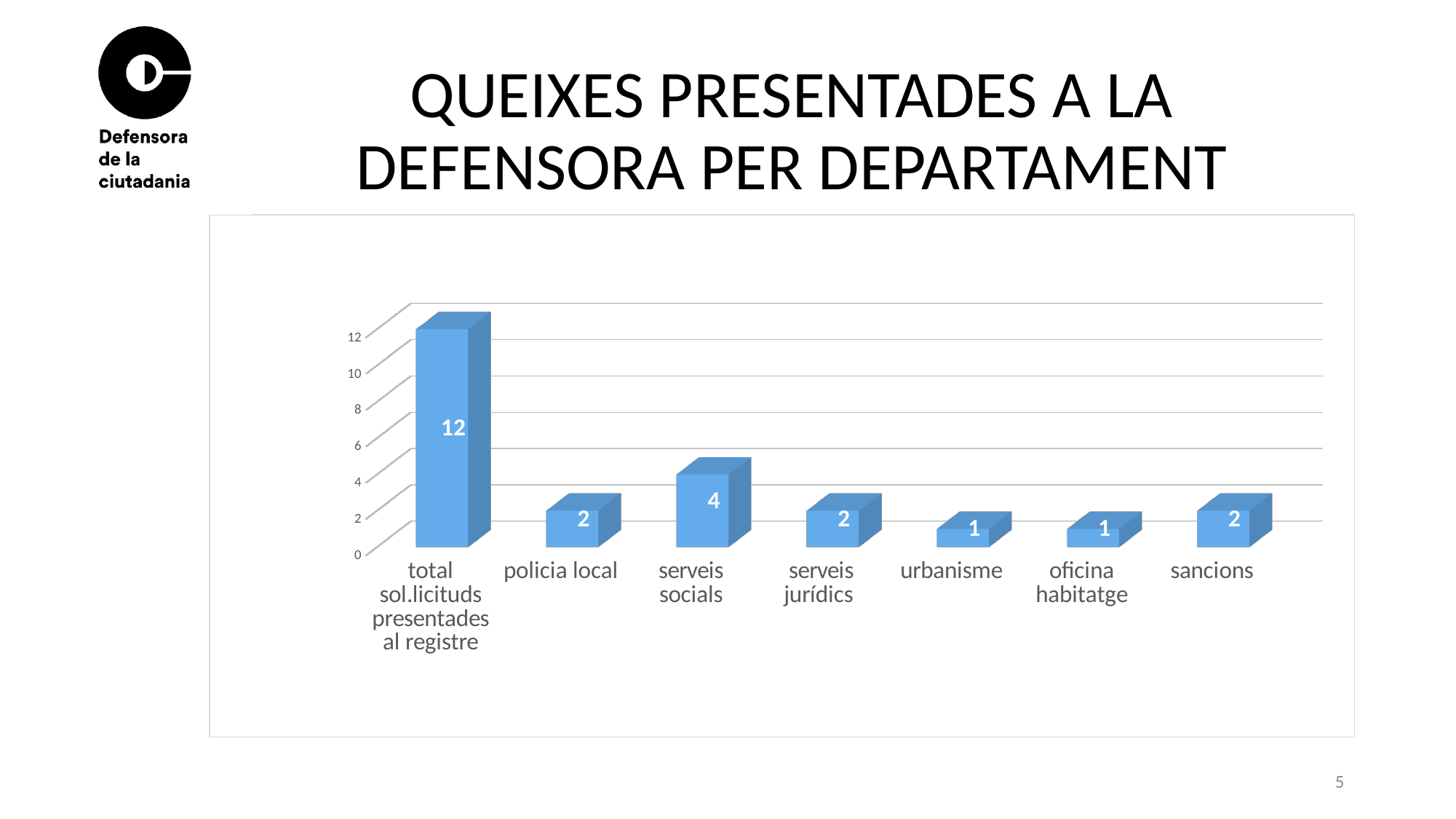
Which is larger, the value for serveis jurídics or the value for oficina habitatge? serveis jurídics What kind of chart is shown on the slide? bar chart What is the value for urbanisme? 1 Which category has the highest value? total sol.licituds presentades al registre What is the title of the slide containing the chart? QUEIXES PRESENTADES A LA DEFENSORA PER DEPARTAMENT How many categories are shown on the x axis? 7 What is the difference between the values for total sol.licituds presentades al registre and serveis socials? 8 Which department has the highest value, excluding the total bar? serveis socials What is the value for sancions? 2 What is the value for serveis socials? 4 What is the difference between the values for serveis socials and policia local? 2 What is the value for total sol.licituds presentades al registre? 12